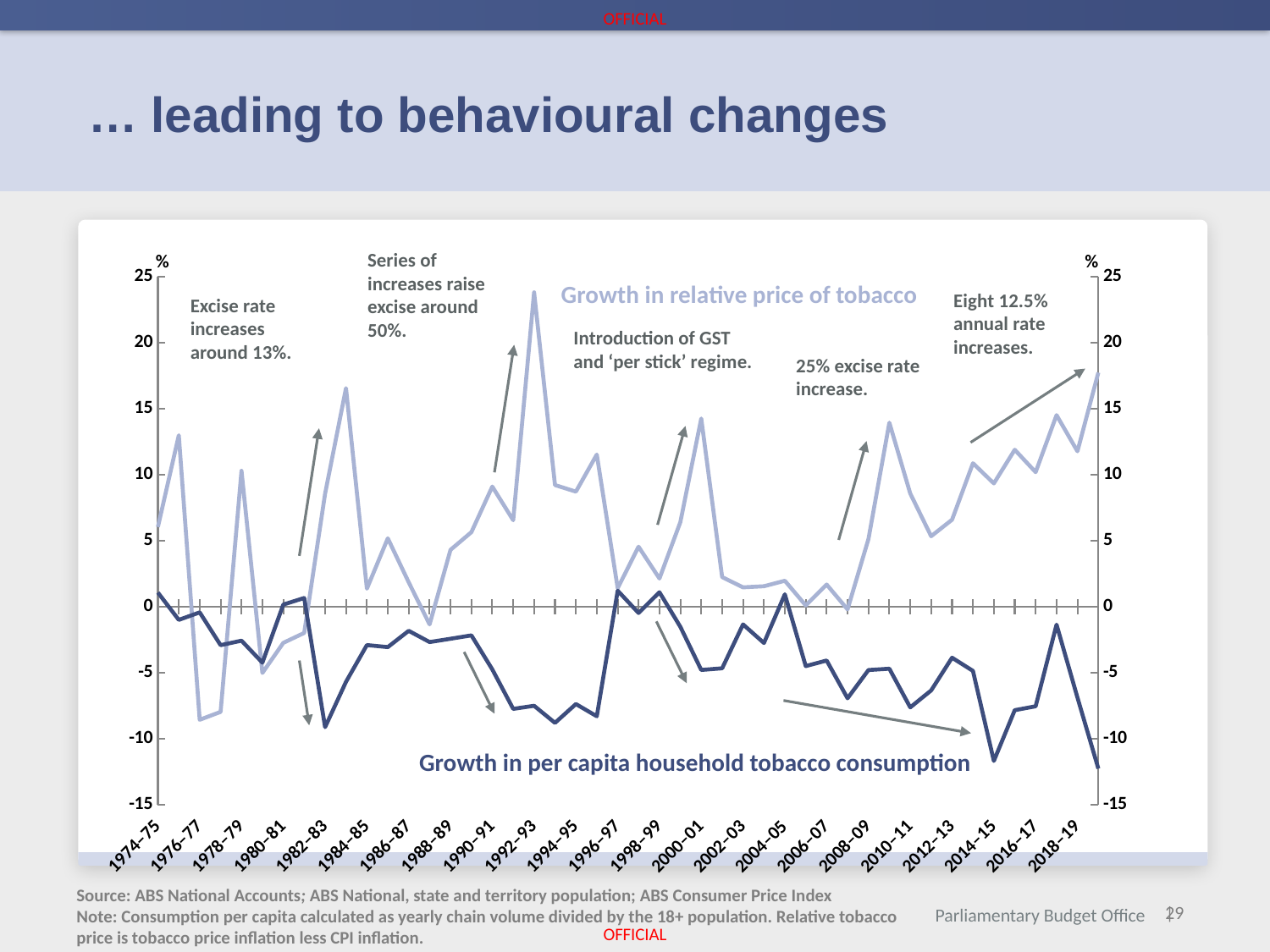
Over the whole period shown, does the growth in per capita household tobacco consumption generally rise or fall? fall In which year does the growth in relative price of tobacco reach its highest value? 1992–93 Is the growth in per capita household tobacco consumption in 2014–15 greater or less than -10? less What kind of chart is shown on the slide? line chart Is the growth in relative price of tobacco in 1992–93 greater or less than 20? greater Which is larger: the growth in per capita household tobacco consumption in 1996–97 or in 2014–15? 1996–97 How many data series are plotted on the chart? 2 Is the growth in relative price of tobacco in 1976–77 greater or less than -5? less What are the names of the two series plotted on the chart? Growth in relative price of tobacco; Growth in per capita household tobacco consumption Which is larger: the growth in relative price of tobacco in 1992–93 or in 1984–85? 1992–93